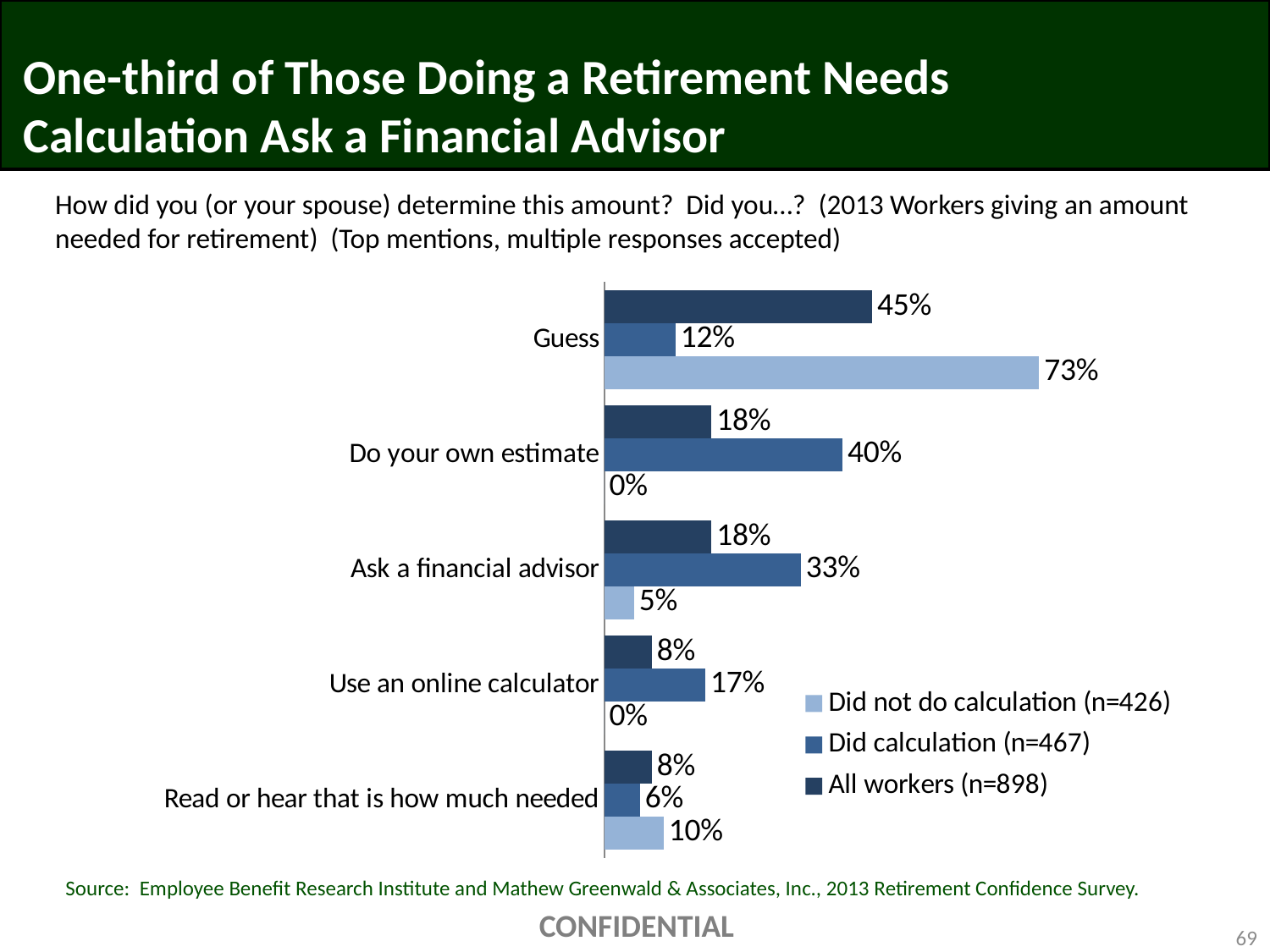
What type of chart is shown on the slide? Bar chart What percentage of those who did a calculation (n=467) said they use an online calculator? 17% Which category has the lowest value for all workers (n=898)? Use an online calculator and Read or hear that is how much needed (both 8%) How many response categories are shown on the chart? 5 How many series does the legend list? 3 For 'Do your own estimate', which is larger: the value for those who did a calculation or for all workers? Did calculation (n=467) What percentage of those who did a calculation (n=467) said they ask a financial advisor? 33% Which category has the highest value for those who did a calculation (n=467)? Do your own estimate What percentage of all workers (n=898) said they guess? 45% Which series is shown in the lightest blue colour in the legend? Did not do calculation (n=426) What percentage of those who did not do a calculation (n=426) said they guess? 73% What is the difference between the 'Did not do calculation' and 'Did calculation' values for Guess? 61 percentage points